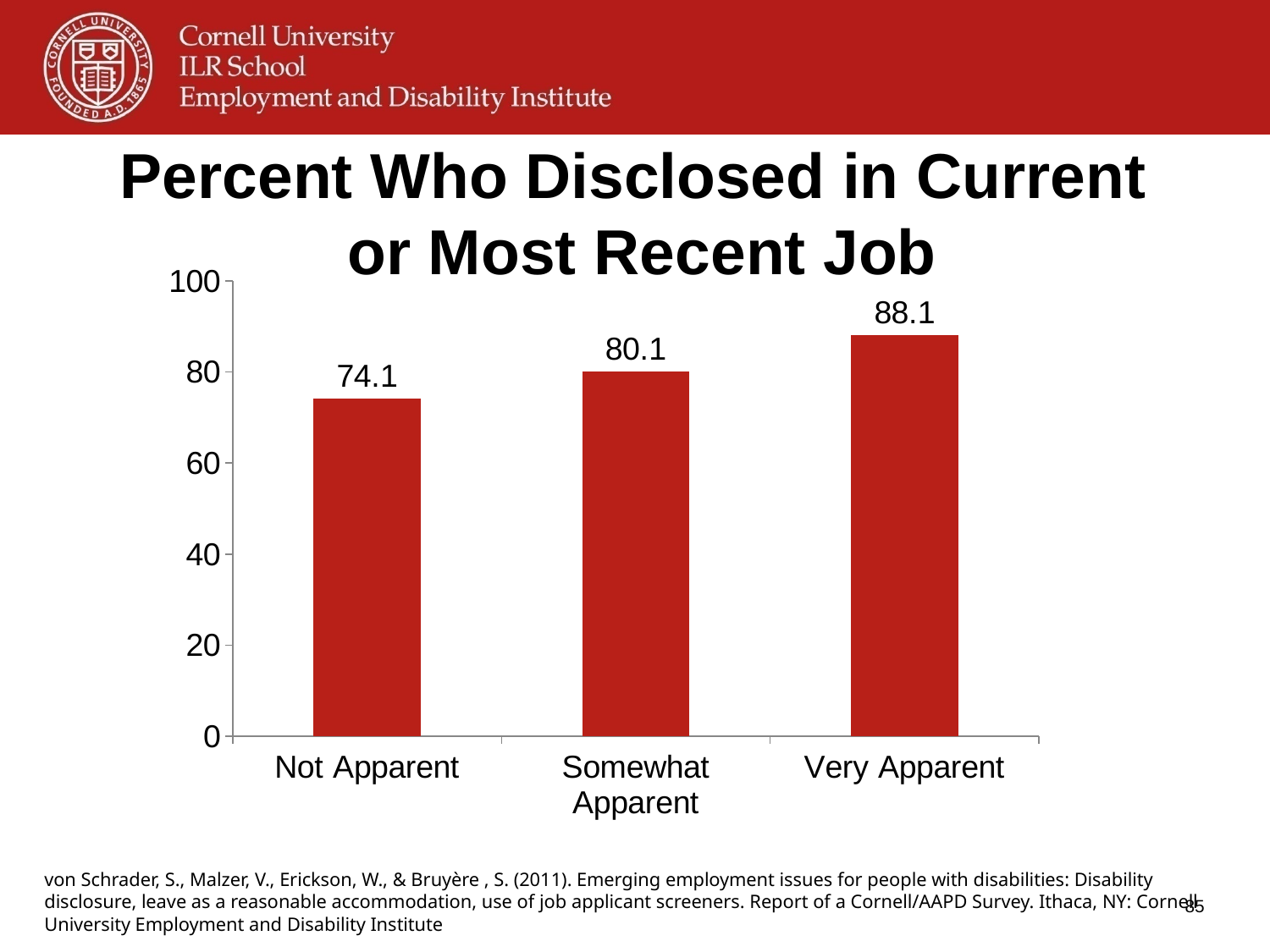
Which is larger, the value for Somewhat Apparent or the value for Very Apparent? Very Apparent What is the difference between the values for Very Apparent and Not Apparent? 14 What is the difference between the values for Somewhat Apparent and Not Apparent? 6 What is the value for Very Apparent? 88.1 Which category has the highest value? Very Apparent What is the value for Not Apparent? 74.1 What is the value for Somewhat Apparent? 80.1 Is the value for Not Apparent greater or less than 80? less Do the values rise or fall from left to right along the x axis? rise Which category has the lowest value? Not Apparent How many categories are shown on the x axis? 3 What kind of chart is shown on the slide? bar chart